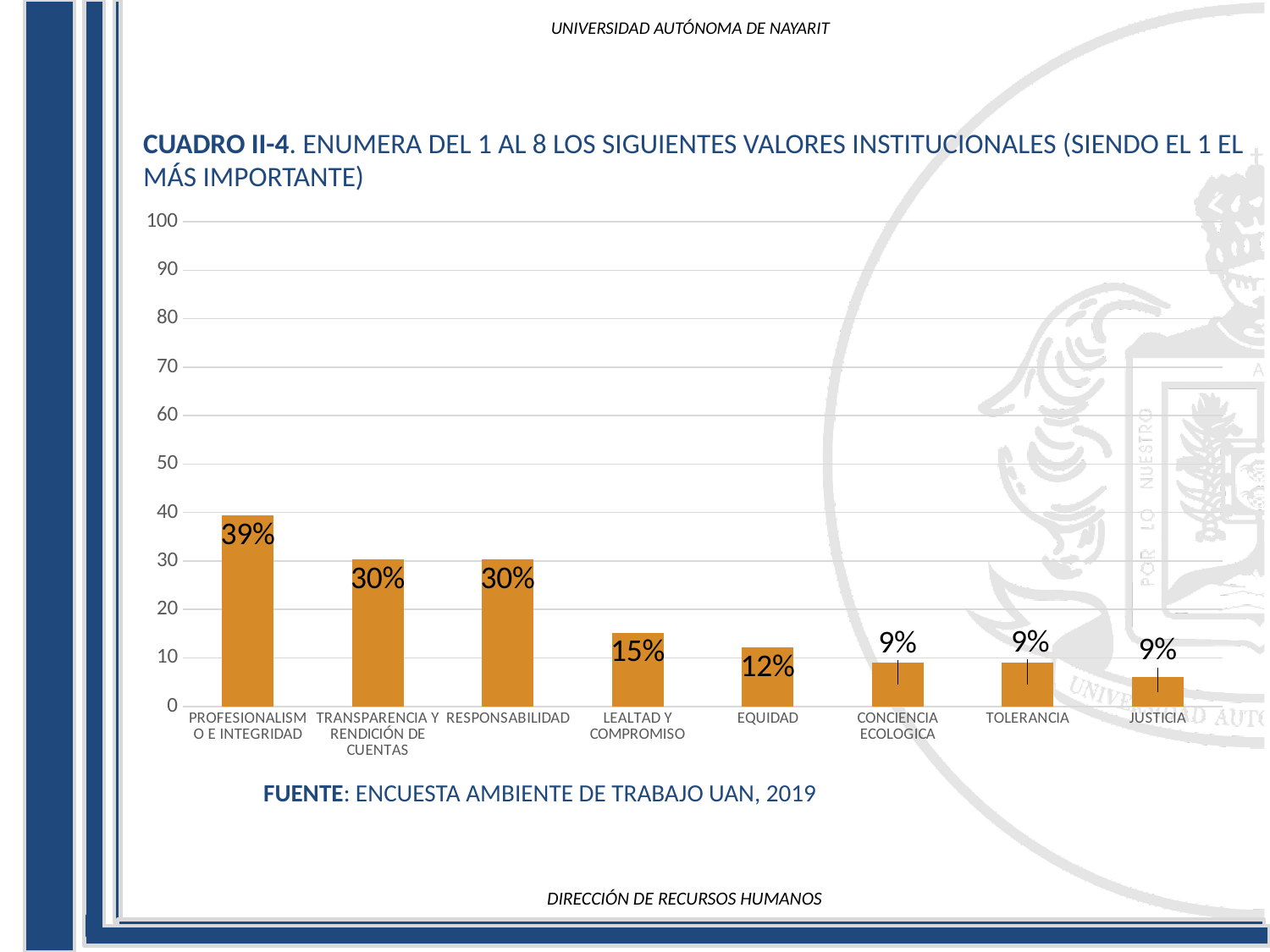
What is the value for TRANSPARENCIA Y RENDICIÓN DE CUENTAS? 30% What kind of chart is shown on the slide? Bar chart What is the value for EQUIDAD? 12% What source is cited below the chart? ENCUESTA AMBIENTE DE TRABAJO UAN, 2019 What is the value for PROFESIONALISMO E INTEGRIDAD? 39% What is the difference between the values for PROFESIONALISMO E INTEGRIDAD and RESPONSABILIDAD? 9 percentage points Which is larger, the value for LEALTAD Y COMPROMISO or the value for EQUIDAD? LEALTAD Y COMPROMISO What is the value for LEALTAD Y COMPROMISO? 15% Is the value for EQUIDAD greater or less than 20? less Which category has the highest value? PROFESIONALISMO E INTEGRIDAD Is the value for PROFESIONALISMO E INTEGRIDAD greater or less than 30? greater How many categories are shown on the chart? 8